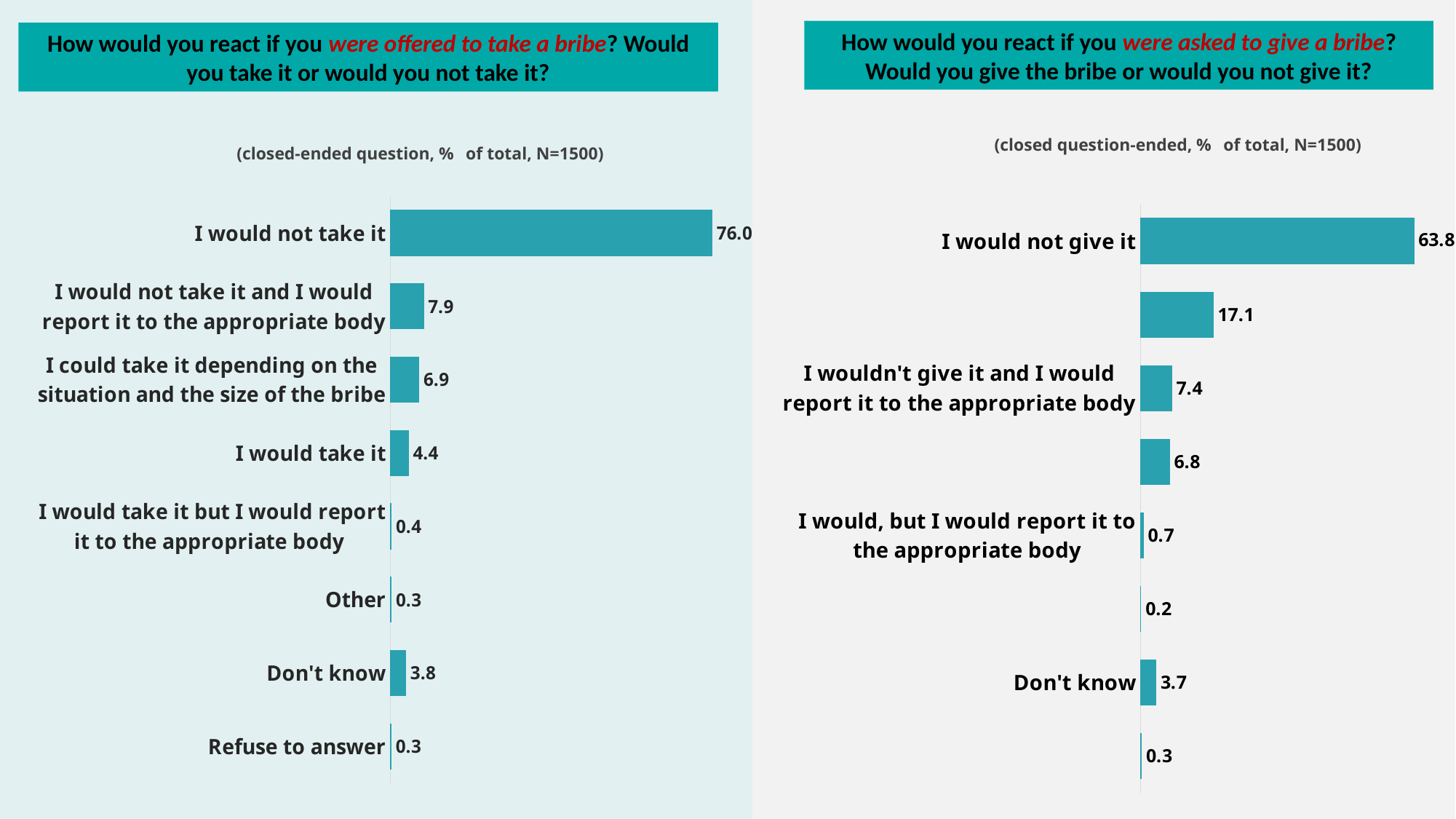
In the left chart (offered to take a bribe), what is the difference between "I would not take it and I would report it to the appropriate body" and "I could take it depending on the situation and the size of the bribe"? 1.0 In the right chart (asked to give a bribe), which is larger: "I would, but I would report it to the appropriate body" or "Don't know"? Don't know In the right chart (asked to give a bribe), what percentage said "I would not give it"? 63.8 In the right chart (asked to give a bribe), what is the value for "I wouldn't give it and I would report it to the appropriate body"? 7.4 In the left chart (offered to take a bribe), what is the value for "Don't know"? 3.8 In the left chart (offered to take a bribe), what percentage said "I would not take it"? 76.0 In the right chart (asked to give a bribe), what is the value for "Don't know"? 3.7 What type of chart is used on the left side of the slide? Bar chart In the left chart (offered to take a bribe), what is the value for "I would take it"? 4.4 Which chart has the higher value for its top category: the left chart ("I would not take it") or the right chart ("I would not give it")? The left chart In the left chart (offered to take a bribe), which category has the highest value? I would not take it In the left chart (offered to take a bribe), how many categories are shown? 8